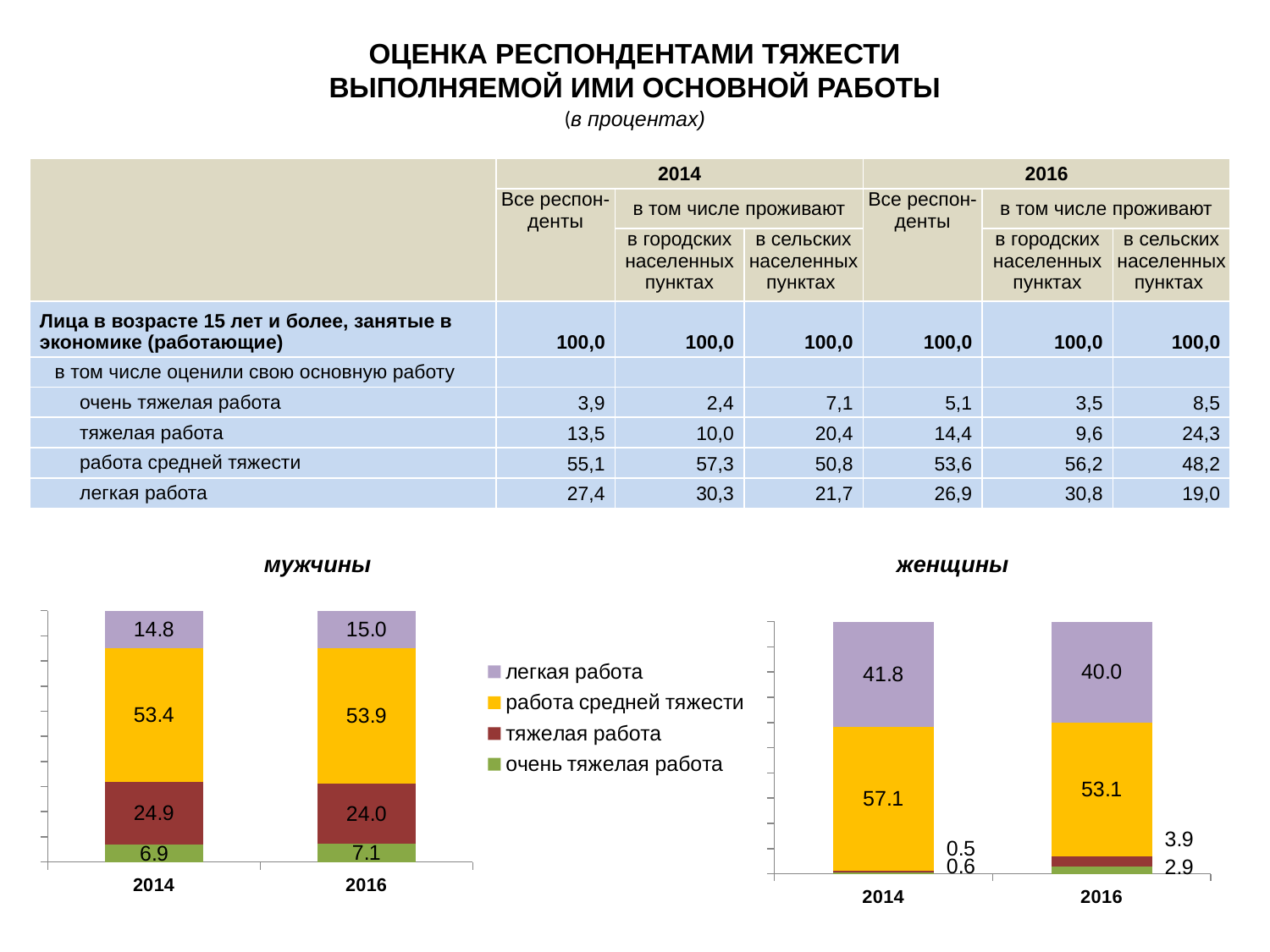
In the "мужчины" chart, what is the difference between the "тяжелая работа" values for 2014 and 2016? 0.9 How many series does the legend list for the charts? 4 How many categories are shown on the x axis of the "женщины" chart? 2 In the "мужчины" chart, what is the total of the stacked bar for 2014? 100.0 In the "женщины" chart, what is the value for "легкая работа" in 2016? 40.0 In the "женщины" chart, what is the difference between the "работа средней тяжести" values for 2014 and 2016? 4.0 What kind of chart is the "мужчины" chart? stacked bar chart In the "мужчины" chart, what is the value for "работа средней тяжести" in 2014? 53.4 In the "мужчины" chart, what is the value for "очень тяжелая работа" in 2016? 7.1 In the "женщины" chart, what is the value for "тяжелая работа" in 2014? 0.5 In the "мужчины" chart, which segment is the largest in the 2016 bar? работа средней тяжести In the "женщины" chart, which year has the larger value for "очень тяжелая работа", 2014 or 2016? 2016